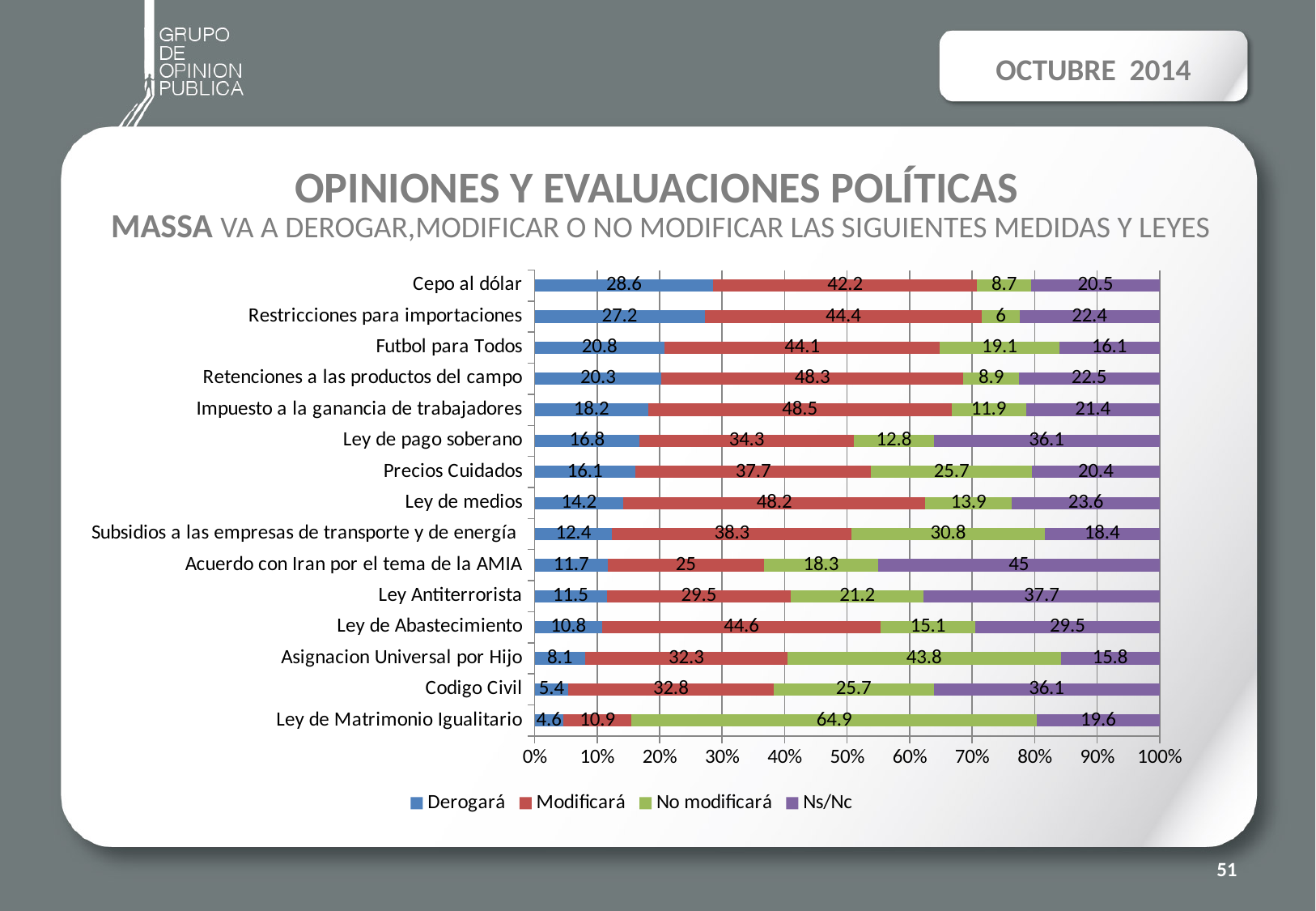
How many categories are shown on the chart? 15 What is the Derogará value for Cepo al dólar? 28.6 Which category has the highest No modificará value? Ley de Matrimonio Igualitario How many series does the legend list? 4 Which category has the lowest Derogará value? Ley de Matrimonio Igualitario What is the difference between the Modificará and Derogará values for Cepo al dólar? 13.6 Which category has the highest Derogará value? Cepo al dólar What is the Ns/Nc value for Acuerdo con Iran por el tema de la AMIA? 45 What is the Modificará value for Ley de Abastecimiento? 44.6 What kind of chart is shown on the slide? Stacked bar chart For Precios Cuidados, which is larger: the No modificará value or the Ns/Nc value? No modificará What is the No modificará value for Ley de Matrimonio Igualitario? 64.9